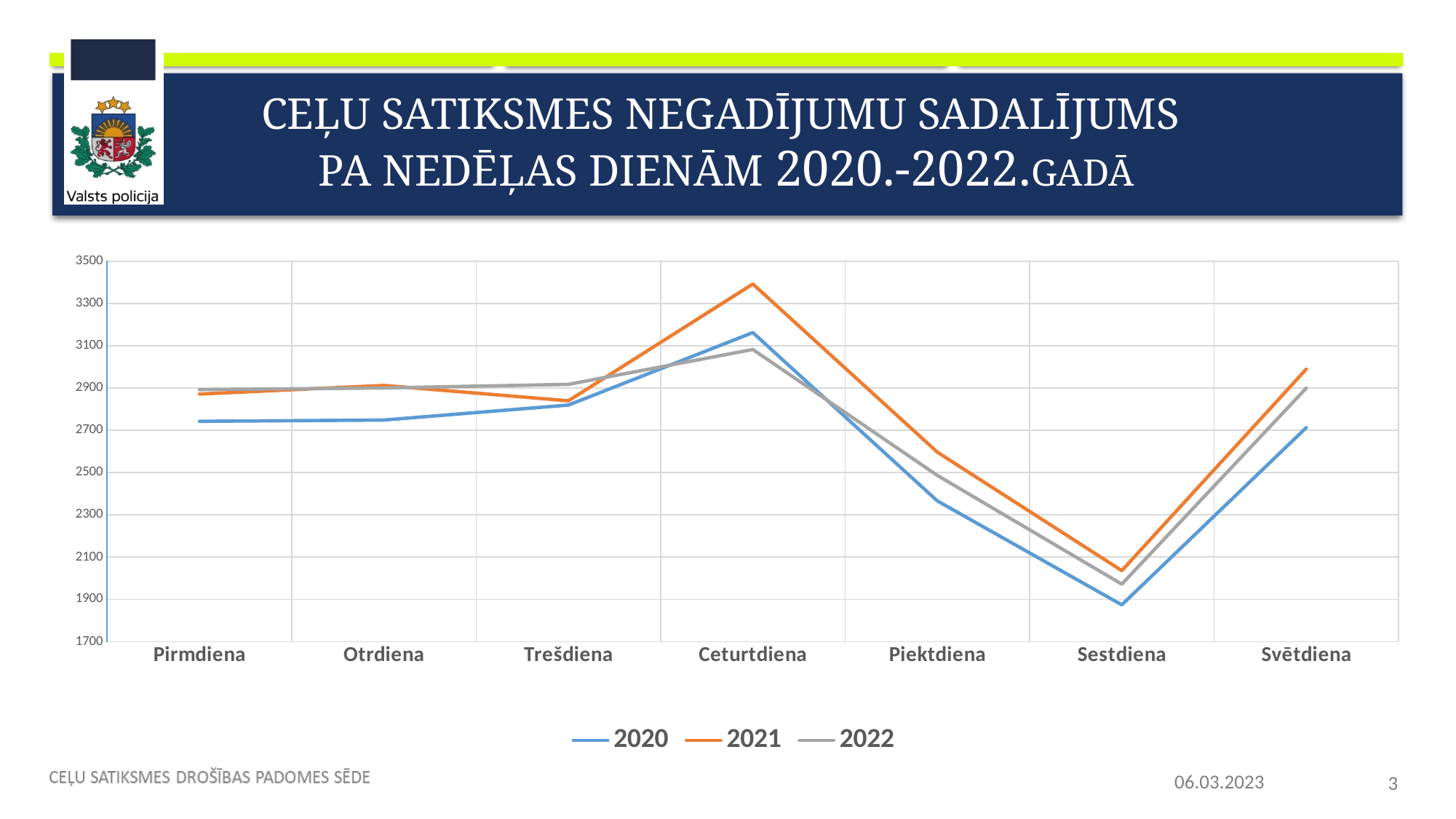
Do the values of the 2021 series rise or fall from Ceturtdiena to Sestdiena? fall Is the 2022 value for Piektdiena greater or less than 2700? less On Ceturtdiena, which series has the larger value, 2020 or 2021? 2021 For the 2020 series, which day has the lowest value? Sestdiena For the 2022 series, which day has the highest value? Ceturtdiena What kind of chart is shown on the slide? line chart For the 2021 series, which day has the highest value? Ceturtdiena Is the 2020 value for Sestdiena greater or less than 2100? less How many series does the legend list? 3 How many categories (days of the week) are shown on the x axis? 7 What colour is the line for the 2021 series? orange Is the 2021 value for Ceturtdiena greater or less than 3300? greater